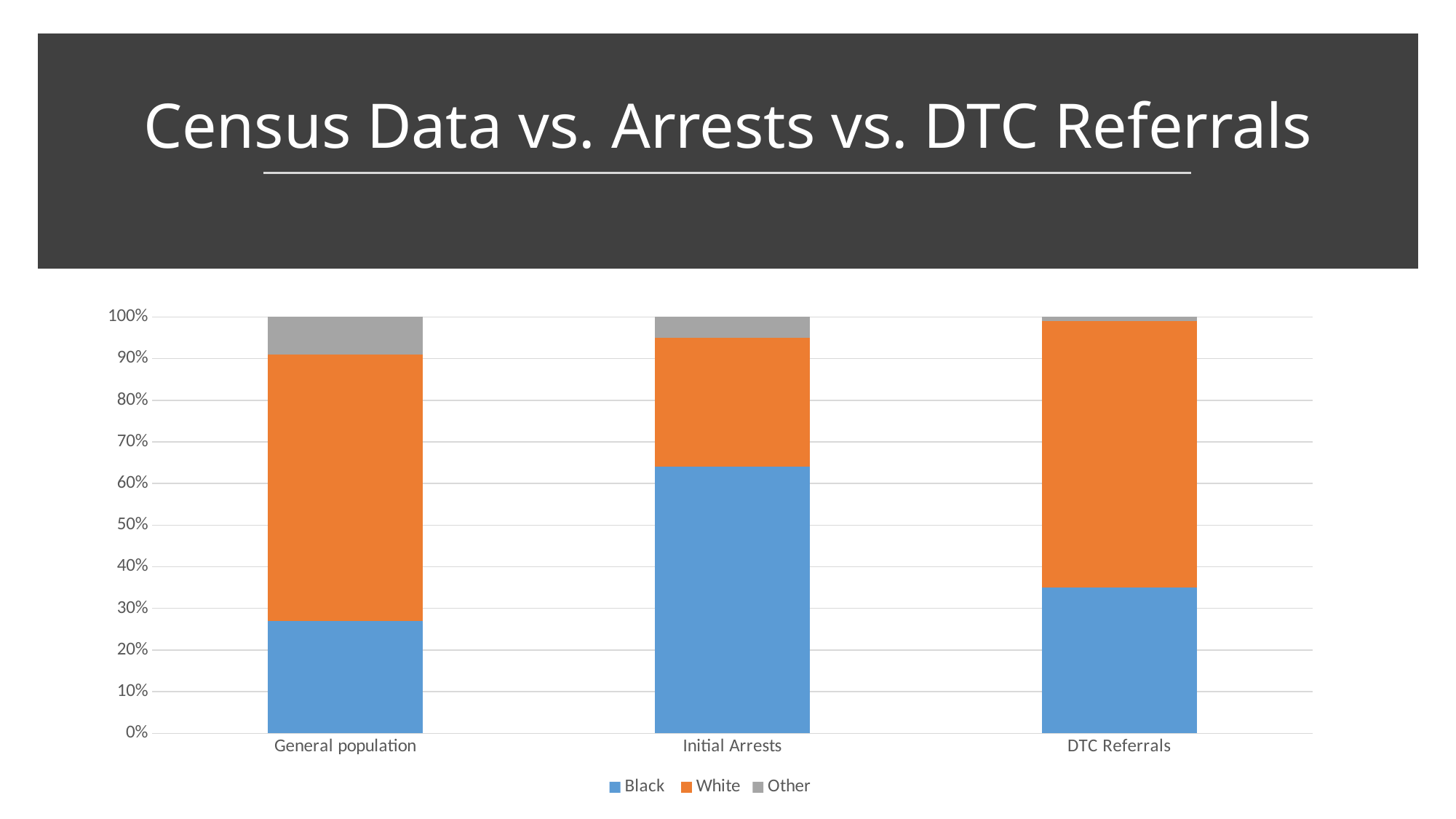
How many categories are shown on the x axis? 3 What kind of chart is shown on the slide? Stacked bar chart How many series does the legend list? 3 Which category has the largest Black share? Initial Arrests What is the title of the slide containing the chart? Census Data vs. Arrests vs. DTC Referrals Is the Black share for Initial Arrests greater or less than 60%? greater What is the total of the stacked bar for General population? 100% Which series is shown in orange in the legend? White Which category has the smallest Other share? DTC Referrals Is the Black share for General population greater or less than 30%? less Is the Black share for DTC Referrals greater or less than 30%? greater Which is larger: the Black share for Initial Arrests or the Black share for DTC Referrals? Initial Arrests